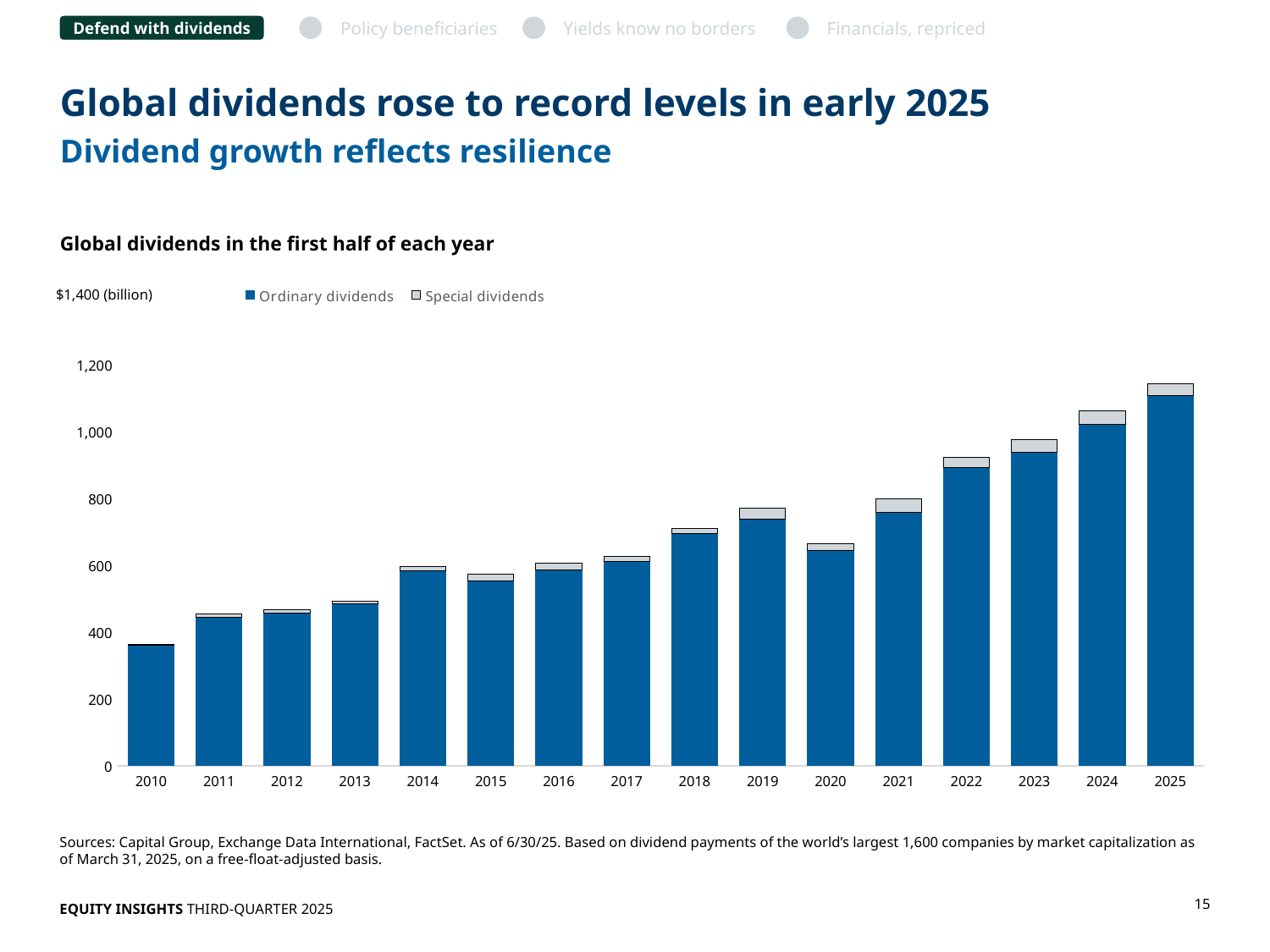
Is the total value for 2020 greater or less than 600? greater What are the two series named in the chart legend? Ordinary dividends and Special dividends Is the total value for 2022 greater or less than 1,000? less How many series does the chart legend list? 2 Do total global dividends generally rise or fall from 2010 to 2025? rise Which year has the lowest total global dividends in the chart? 2010 Is the total value for 2025 greater or less than 1,000? greater Which year has the highest total global dividends in the chart? 2025 Which year has the larger total dividends, 2019 or 2020? 2019 What kind of chart is shown on the slide? Stacked bar chart How many years are shown on the x axis of the chart? 16